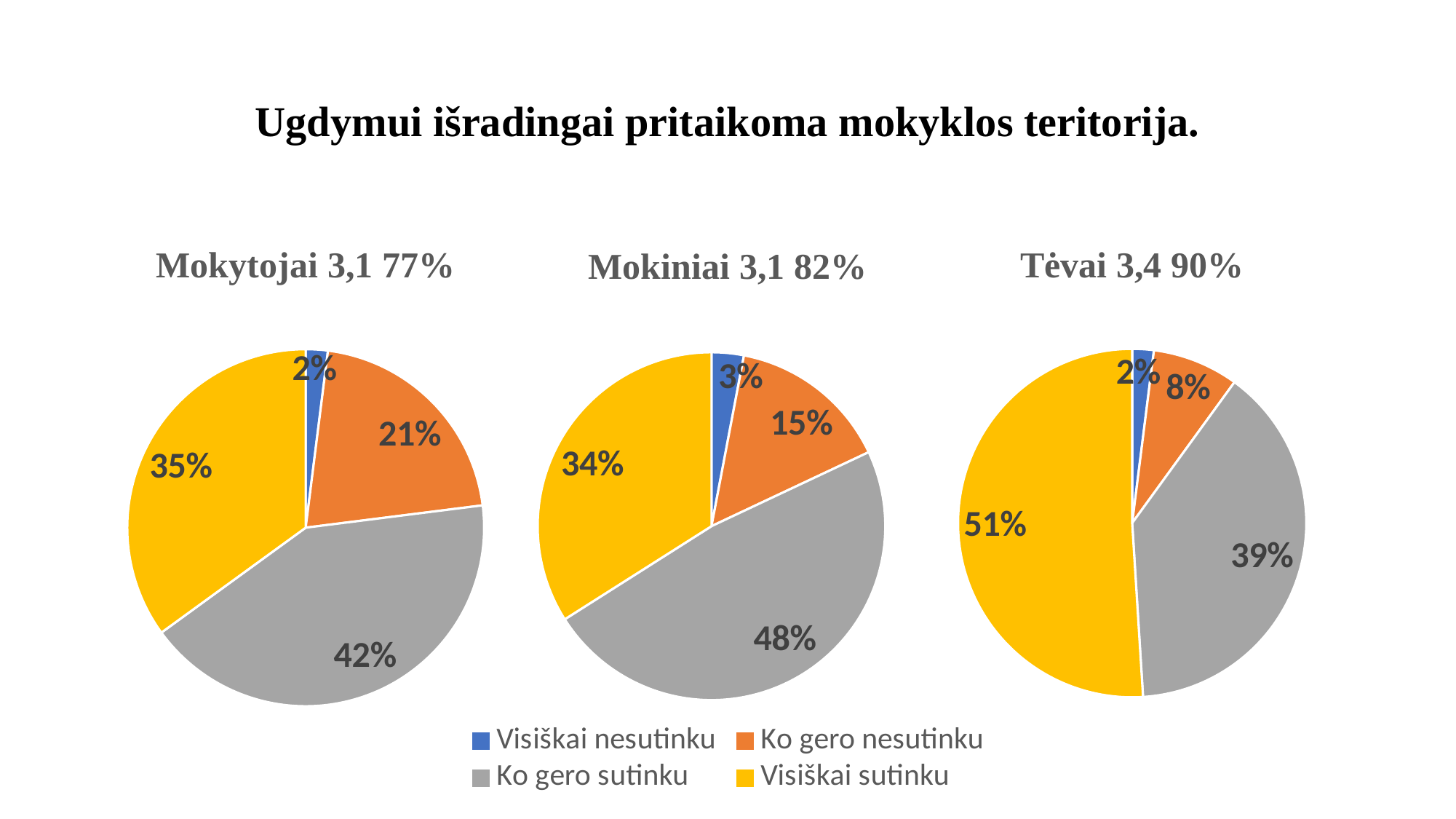
Which is larger: the "Ko gero nesutinku" share in the "Mokytojai 3,1 77%" chart or in the "Mokiniai 3,1 82%" chart? Mokytojai 3,1 77% In the "Tėvai 3,4 90%" pie chart, what share is labelled for "Visiškai sutinku"? 51% In the "Tėvai 3,4 90%" pie chart, which category has the largest slice? Visiškai sutinku How many slices does the "Mokiniai 3,1 82%" pie chart have? 4 How many entries does the legend list? 4 In the "Mokytojai 3,1 77%" pie chart, what share is labelled for "Ko gero sutinku"? 42% In the "Mokiniai 3,1 82%" pie chart, what share is labelled for "Ko gero nesutinku"? 15% In the "Mokytojai 3,1 77%" pie chart, which category has the smallest slice? Visiškai nesutinku What type of chart is used on this slide? Pie chart In the "Mokytojai 3,1 77%" pie chart, what is the difference between the "Ko gero sutinku" and "Visiškai sutinku" shares? 7% In the "Mokiniai 3,1 82%" pie chart, which category has the largest slice? Ko gero sutinku In the "Tėvai 3,4 90%" pie chart, what is the difference between the "Ko gero sutinku" and "Ko gero nesutinku" shares? 31%